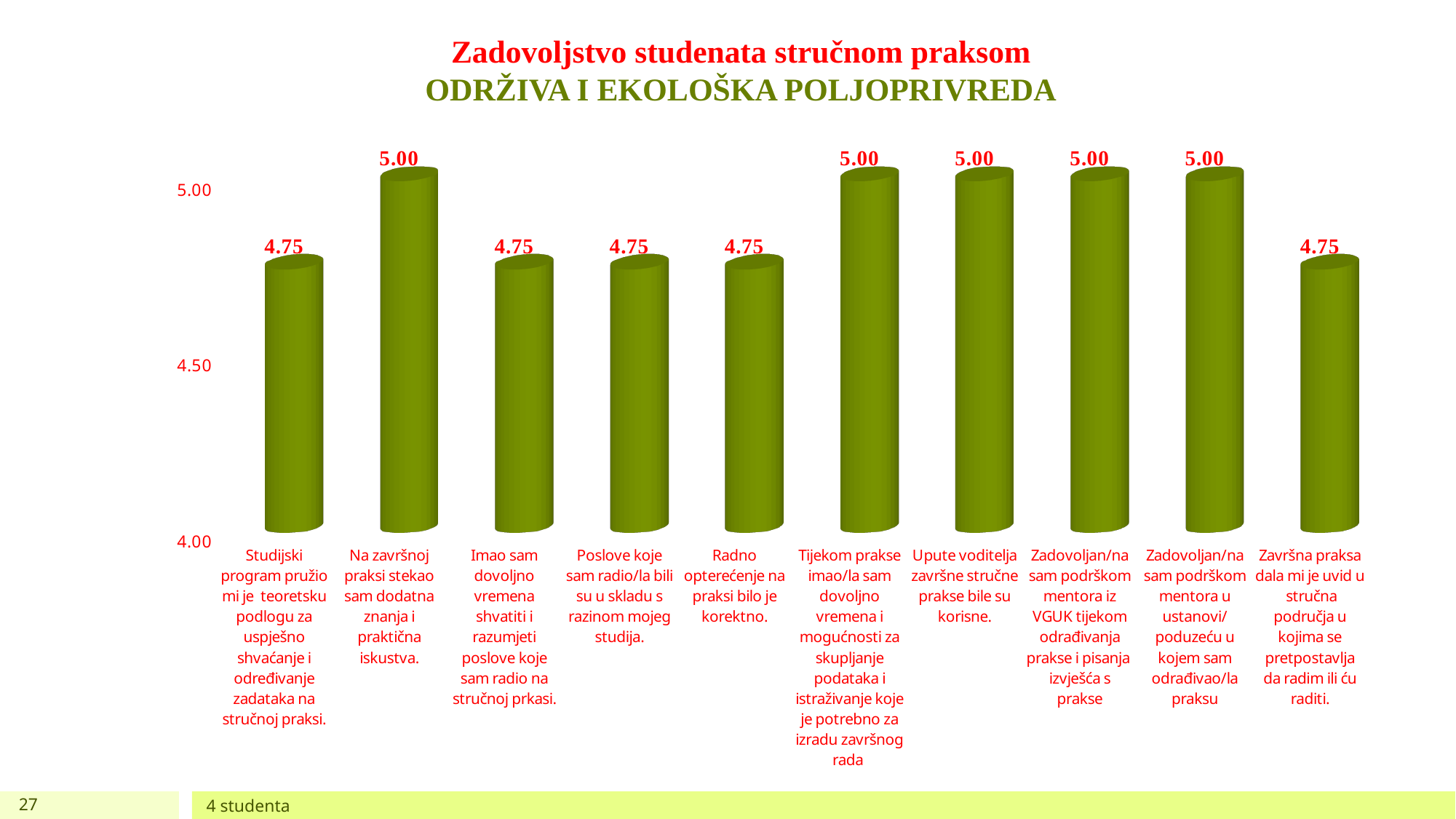
What is the difference between the value for "Na završnoj praksi stekao sam dodatna znanja i praktična iskustva." and the value for "Imao sam dovoljno vremena shvatiti i razumjeti poslove koje sam radio na stručnoj prkasi."? 0.25 What is the lowest value shown on the vertical axis? 4.00 How many bars have a value of 5.00? 5 What kind of chart is shown on the slide? bar chart Is the value for "Studijski program pružio mi je teoretsku podlogu za uspješno shvaćanje i određivanje zadataka na stručnoj praksi." greater or less than 4.50? greater How many categories are shown in the chart? 10 What is the value for "Radno opterećenje na praksi bilo je korektno."? 4.75 Which has a larger value: "Tijekom prakse imao/la sam dovoljno vremena i mogućnosti za skupljanje podataka i istraživanje koje je potrebno za izradu završnog rada" or "Poslove koje sam radio/la bili su u skladu s razinom mojeg studija."? Tijekom prakse imao/la sam dovoljno vremena i mogućnosti za skupljanje podataka i istraživanje koje je potrebno za izradu završnog rada What is the title of the chart? Zadovoljstvo studenata stručnom praksom ODRŽIVA I EKOLOŠKA POLJOPRIVREDA What is the value for "Na završnoj praksi stekao sam dodatna znanja i praktična iskustva."? 5.00 What is the value for "Upute voditelja završne stručne prakse bile su korisne."? 5.00 What is the value for "Završna praksa dala mi je uvid u stručna područja u kojima se pretpostavlja da radim ili ću raditi."? 4.75